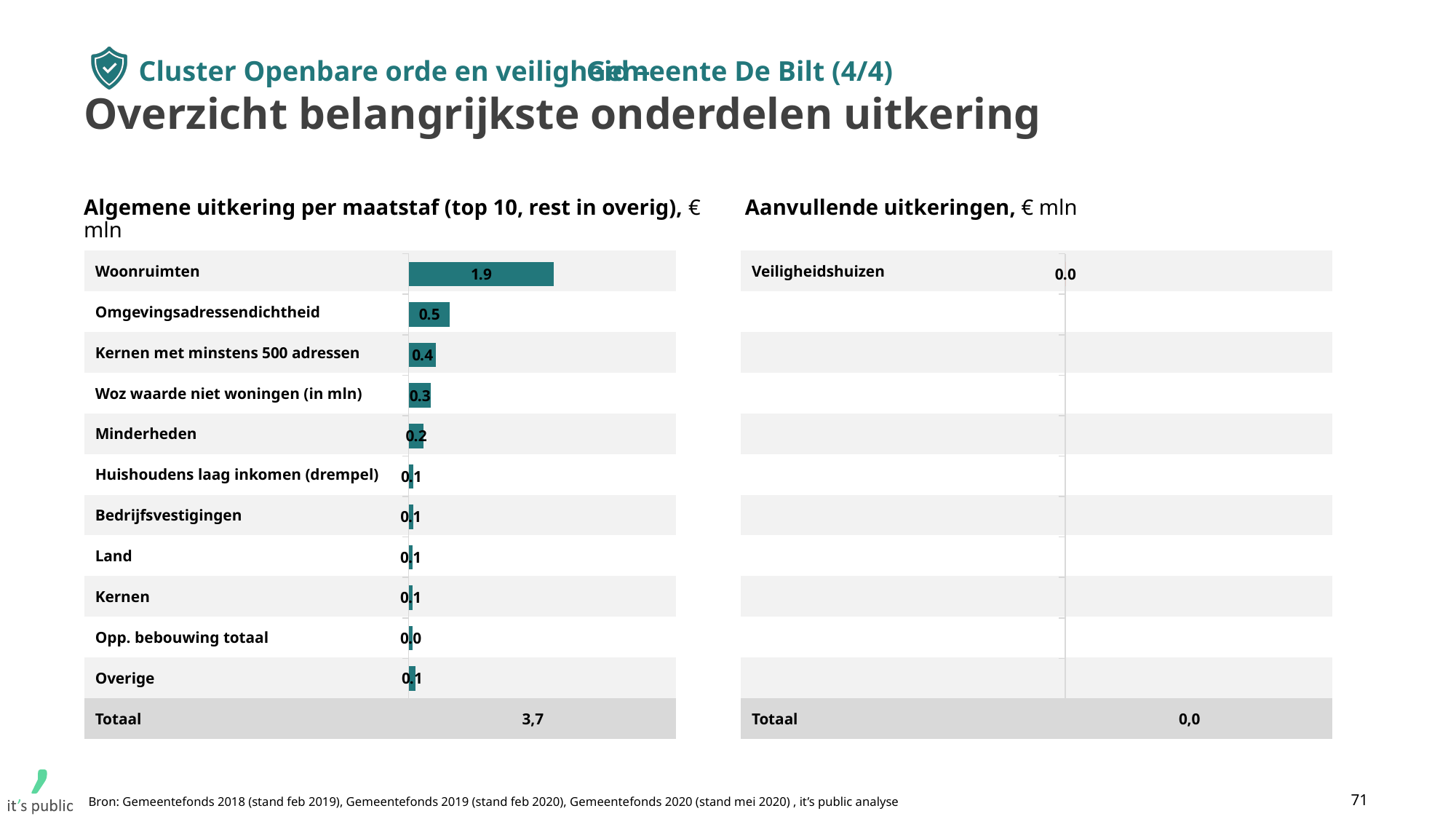
What is the total shown for the 'Algemene uitkering per maatstaf' chart? 3,7 In the 'Algemene uitkering per maatstaf' chart, what is the value for Kernen met minstens 500 adressen? 0.4 In the 'Algemene uitkering per maatstaf' chart, what is the value for Woz waarde niet woningen (in mln)? 0.3 In the 'Algemene uitkering per maatstaf' chart, which category has the lowest value? Opp. bebouwing totaal In the 'Algemene uitkering per maatstaf' chart, what is the difference between Woonruimten and Omgevingsadressendichtheid? 1.4 In the 'Algemene uitkering per maatstaf' chart, what is the value for Woonruimten? 1.9 In the 'Algemene uitkering per maatstaf' chart, which is larger: Minderheden or Kernen met minstens 500 adressen? Kernen met minstens 500 adressen In the 'Algemene uitkering per maatstaf' chart, which category has the highest value? Woonruimten In the 'Aanvullende uitkeringen' chart, what is the value for Veiligheidshuizen? 0.0 What kind of chart is the 'Algemene uitkering per maatstaf' chart? Bar chart In the 'Algemene uitkering per maatstaf' chart, what is the value for Omgevingsadressendichtheid? 0.5 How many categories (excluding the total row) are shown in the 'Algemene uitkering per maatstaf' chart? 11